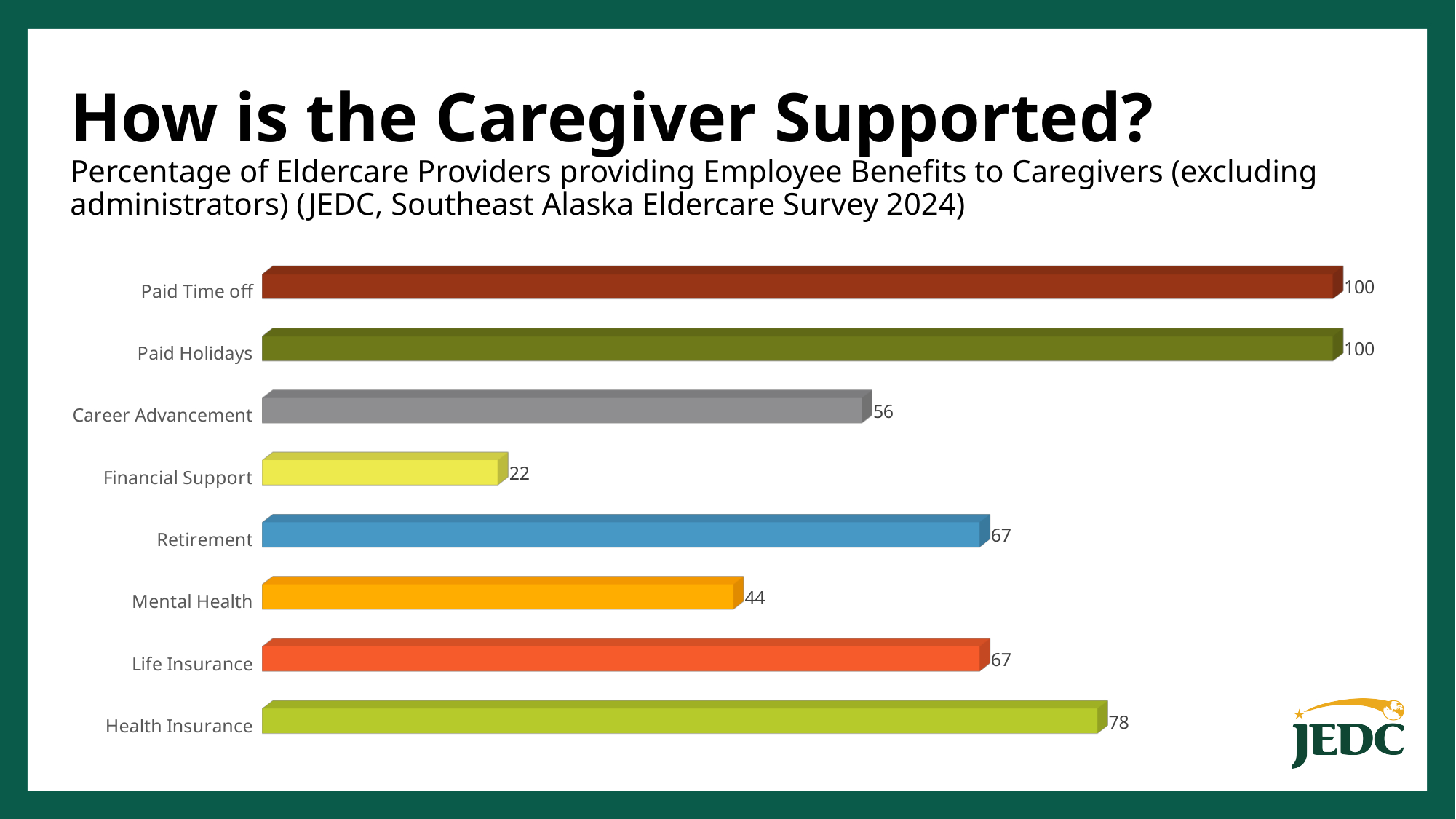
How many categories are shown in the chart? 8 What is the value for Retirement? 67 Which category has the lowest value? Financial Support Which is larger, the value for Life Insurance or the value for Career Advancement? Life Insurance What is the value for Health Insurance? 78 What is the value for Mental Health? 44 What is the value for Career Advancement? 56 What is the difference between the values for Health Insurance and Mental Health? 34 What kind of chart is shown on the slide? Bar chart What is the difference between the values for Career Advancement and Financial Support? 34 What colour is the bar for Mental Health? Orange Which two categories share the highest value of 100? Paid Time off and Paid Holidays